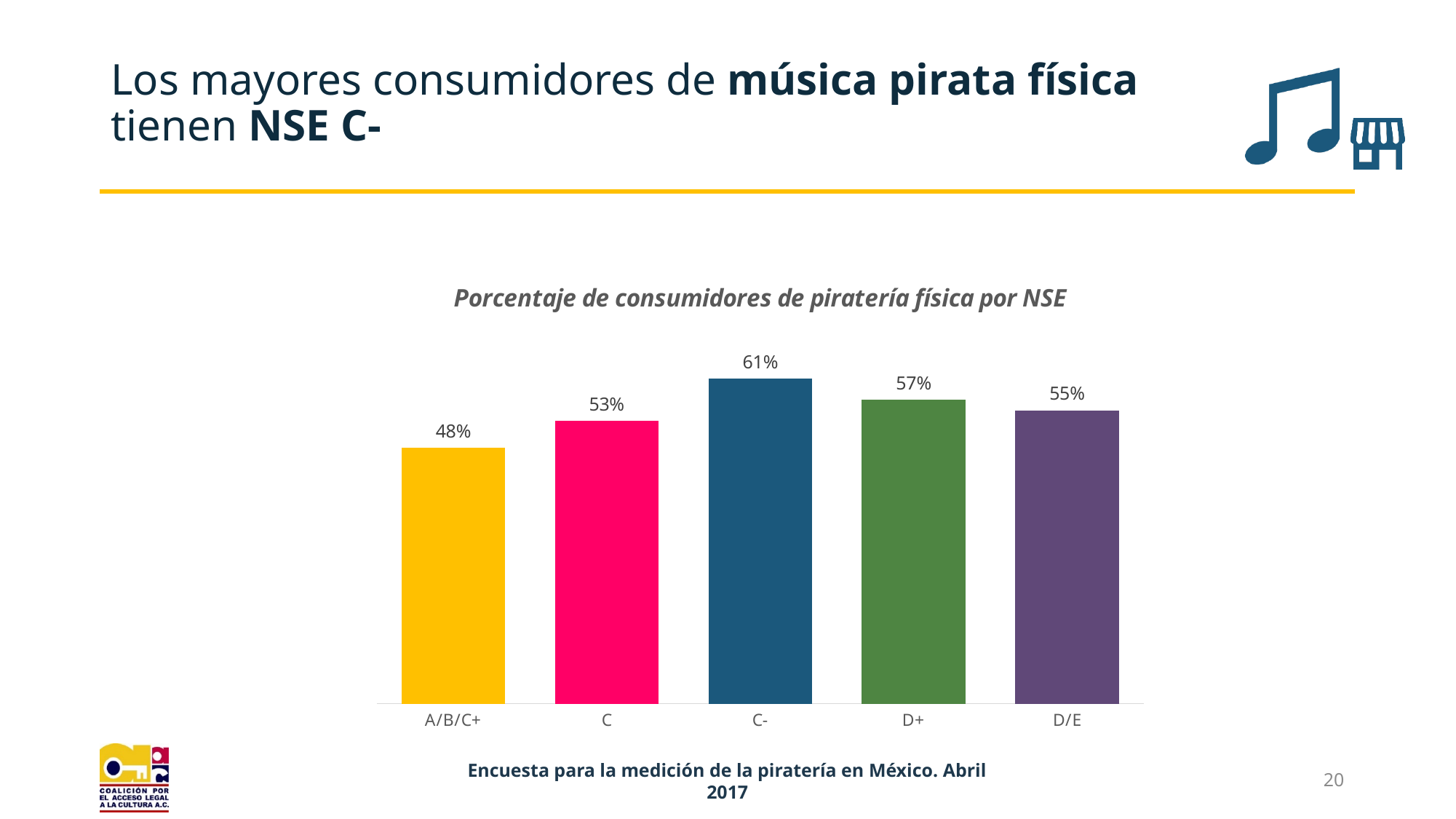
What is the title of the chart? Porcentaje de consumidores de piratería física por NSE What kind of chart is shown on the slide? Bar chart What is the value for D/E in the chart? 55% What colour is the bar for C-? Dark blue What is the value for A/B/C+ in the chart? 48% Which NSE category has the lowest percentage of physical piracy consumers? A/B/C+ Which NSE category has the highest percentage of physical piracy consumers? C- What is the value for C- in the chart? 61% How many NSE categories are shown in the chart? 5 What is the difference between the values for C- and A/B/C+? 13 percentage points Which is larger, the value for C or the value for D+? D+ What is the difference between the values for D+ and D/E? 2 percentage points